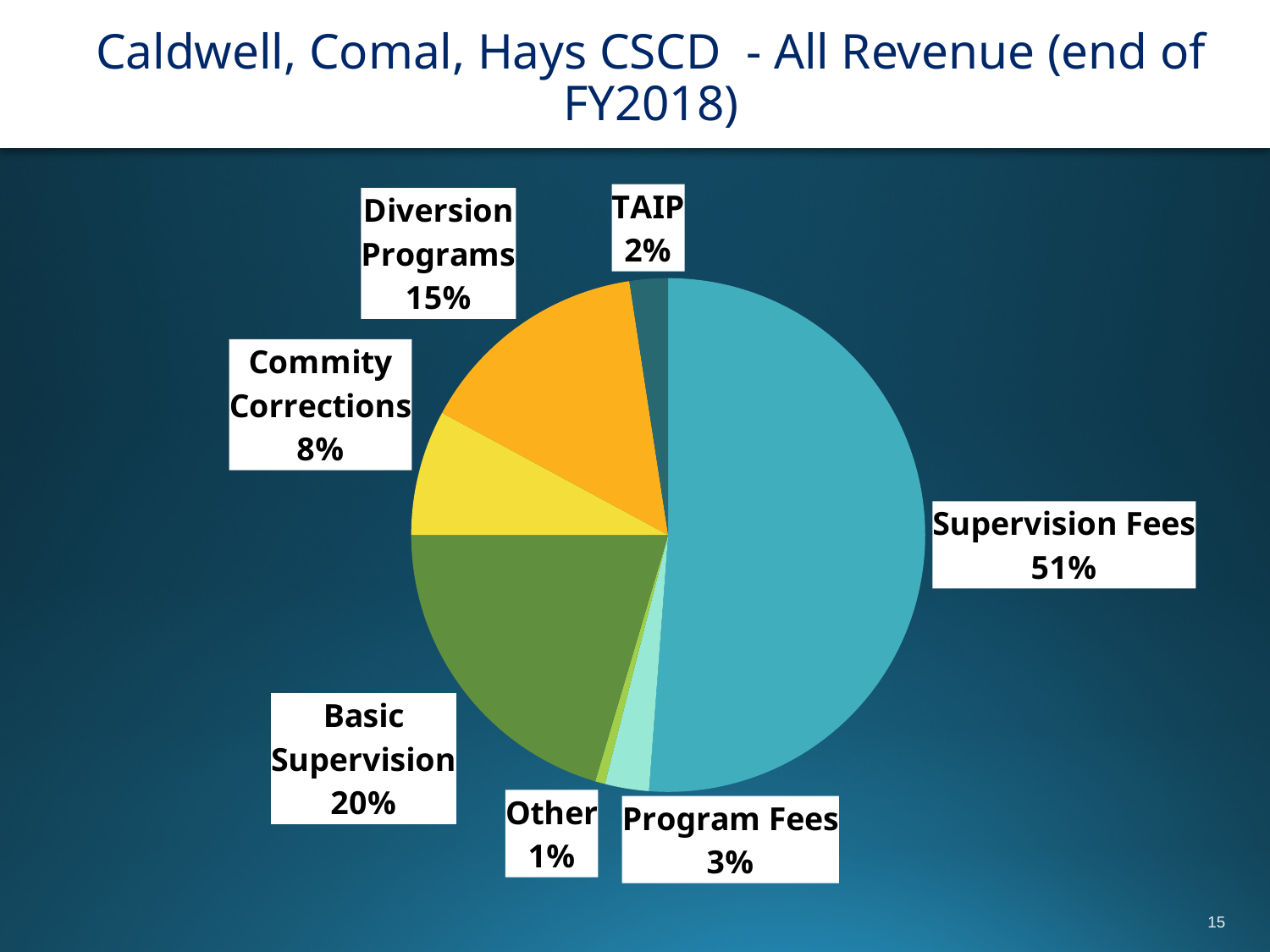
Which revenue category has the smallest share? Other How many slices does the pie chart have? 7 What percentage is shown for TAIP? 2% What is the difference in percentage points between Supervision Fees and Basic Supervision? 31 Which revenue category has the largest share? Supervision Fees What percentage is shown for Diversion Programs? 15% What kind of chart is shown on the slide? pie chart What share of revenue comes from Supervision Fees? 51% What is the title of the slide? Caldwell, Comal, Hays CSCD - All Revenue (end of FY2018) Which is larger, Commity Corrections or Program Fees? Commity Corrections What share of revenue comes from Basic Supervision? 20% What is the difference in percentage points between Basic Supervision and Diversion Programs? 5